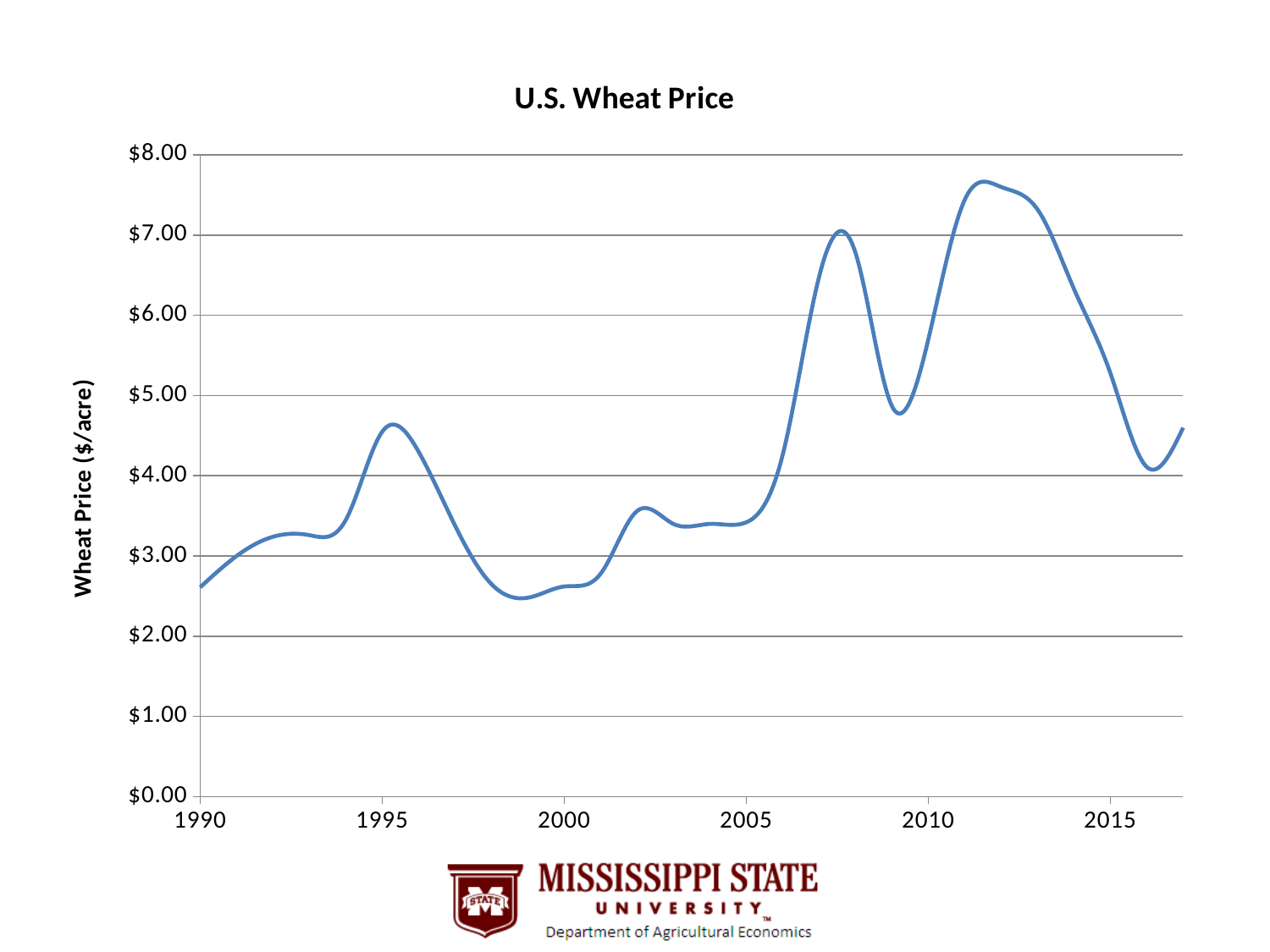
Does the wheat price rise or fall between 2013 and 2016? fall Does the wheat price rise or fall between 1990 and 1995? rise Is the wheat price in 1995 greater or less than $4.00? greater Is the wheat price in 2012 greater or less than $7.00? greater What is the label on the vertical axis? Wheat Price ($/acre) What is the title of the chart? U.S. Wheat Price Is the wheat price in 2005 greater or less than $4.00? less Is the wheat price higher in 2012 or in 1995? 2012 What kind of chart is shown on the slide? line chart